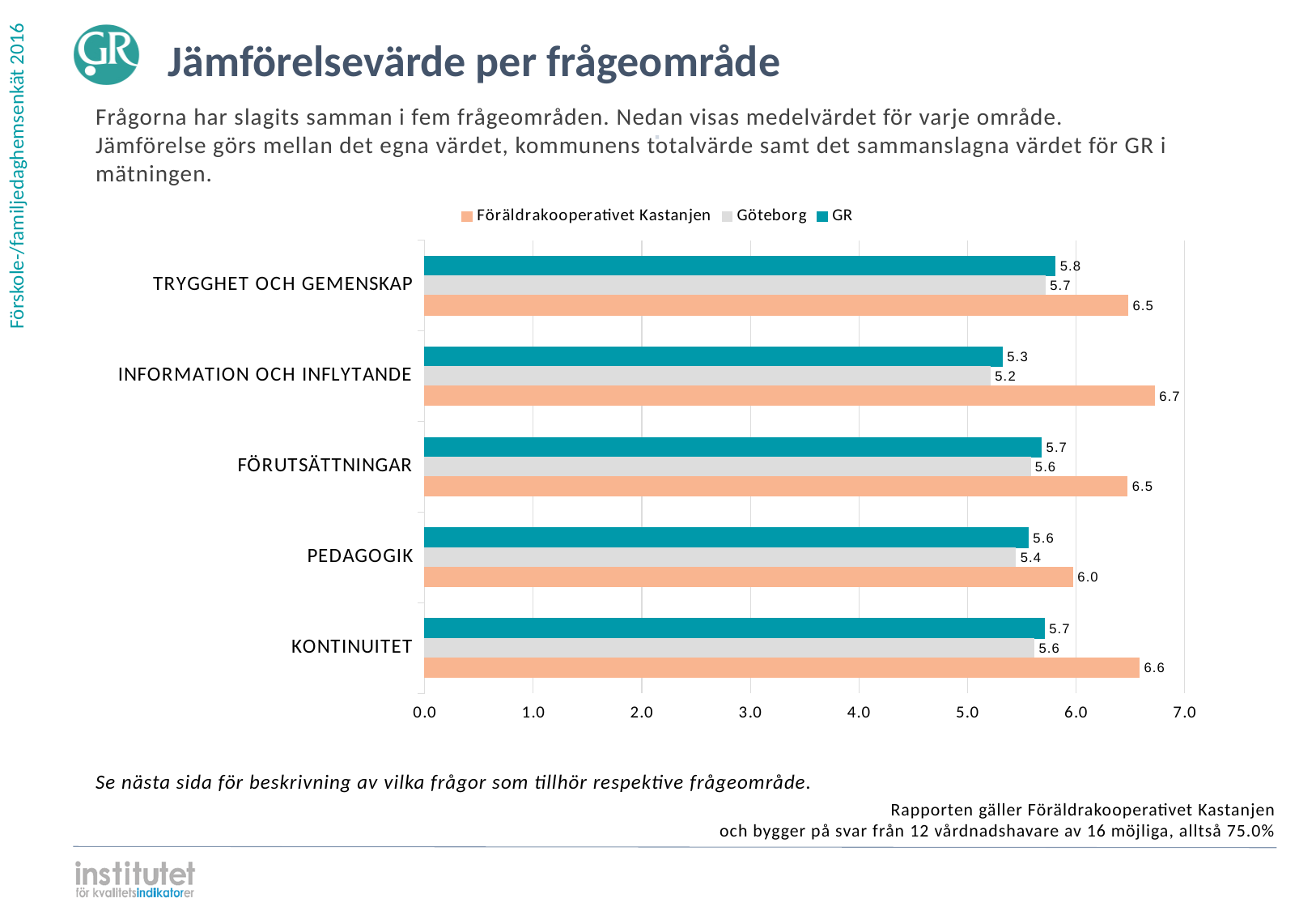
What is the title of the chart on the slide? Jämförelsevärde per frågeområde Which is larger in the PEDAGOGIK category: the GR value or the Göteborg value? GR How many categories are shown on the chart? 5 Which category has the highest value for Föräldrakooperativet Kastanjen? INFORMATION OCH INFLYTANDE What kind of chart is shown on the slide? Bar chart What is the difference between the Föräldrakooperativet Kastanjen value and the Göteborg value in the KONTINUITET category? 1.0 Which category has the lowest value for Göteborg? INFORMATION OCH INFLYTANDE Is the value for Föräldrakooperativet Kastanjen in the PEDAGOGIK category greater or less than 5.0? greater What is the value for GR in the TRYGGHET OCH GEMENSKAP category? 5.8 How many series does the legend list? 3 What is the value for Föräldrakooperativet Kastanjen in the INFORMATION OCH INFLYTANDE category? 6.7 What is the value for Göteborg in the PEDAGOGIK category? 5.4